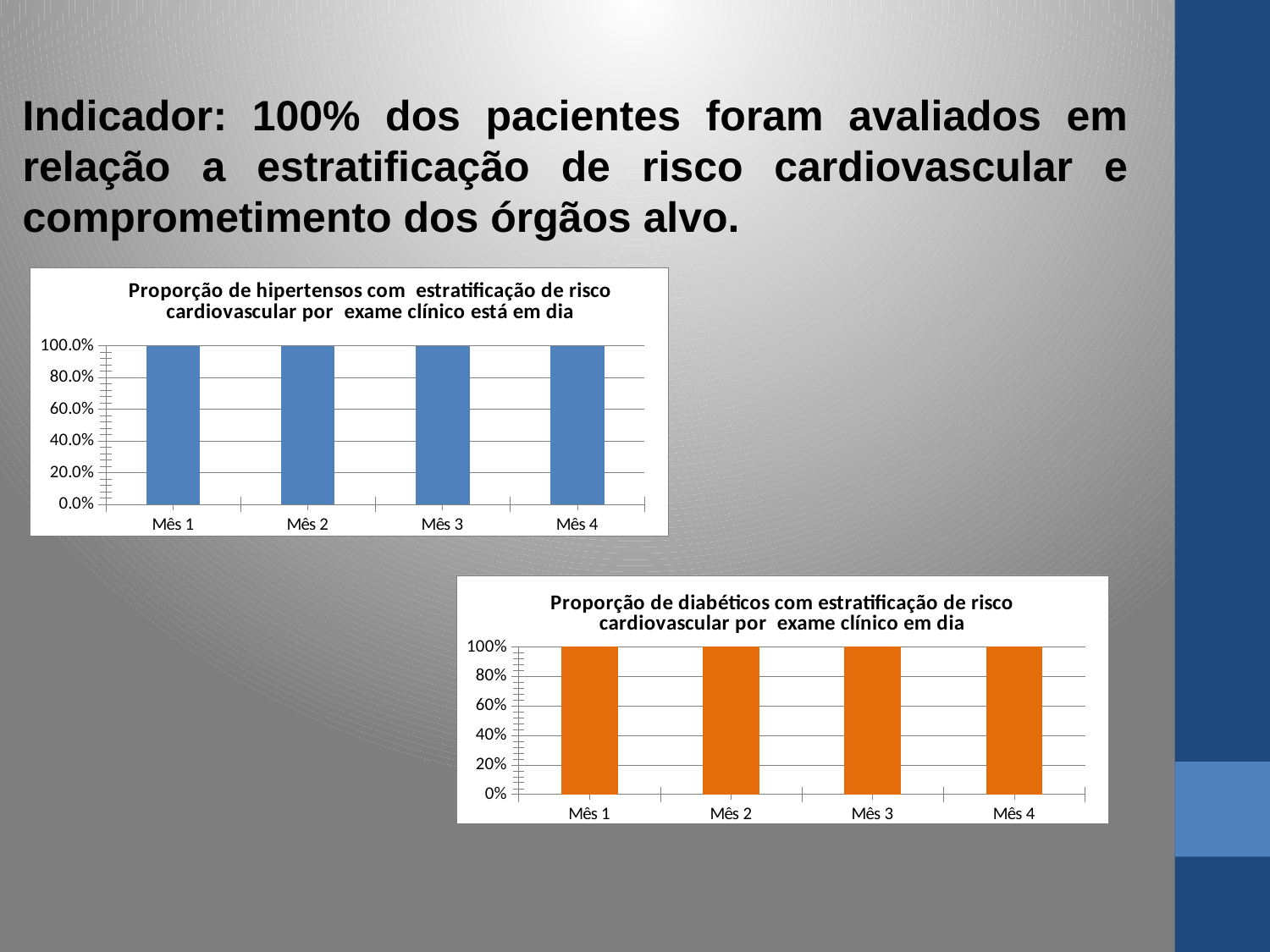
In the chart titled 'Proporção de hipertensos com estratificação de risco cardiovascular por exame clínico está em dia', what is the value for Mês 1? 100.0% In the chart titled 'Proporção de diabéticos com estratificação de risco cardiovascular por exame clínico em dia', what is the value for Mês 3? 100% In the upper chart about hipertensos, is the value for Mês 2 greater or less than 80.0%? greater In the upper chart about hipertensos, do the values rise, fall or stay the same from Mês 1 to Mês 4? Stay the same What kind of chart is the upper chart about hipertensos? Bar chart What kind of chart is the lower chart about diabéticos? Bar chart In the lower chart about diabéticos, is the value for Mês 4 greater or less than 60%? greater In the lower chart about diabéticos, do the values rise, fall or stay the same across the months? Stay the same What is the title of the upper chart on the slide? Proporção de hipertensos com estratificação de risco cardiovascular por exame clínico está em dia In the lower chart about diabéticos, how many bars are plotted? 4 In the upper chart about hipertensos, how many categories are shown on the x axis? 4 What colour are the bars in the lower chart about diabéticos? Orange